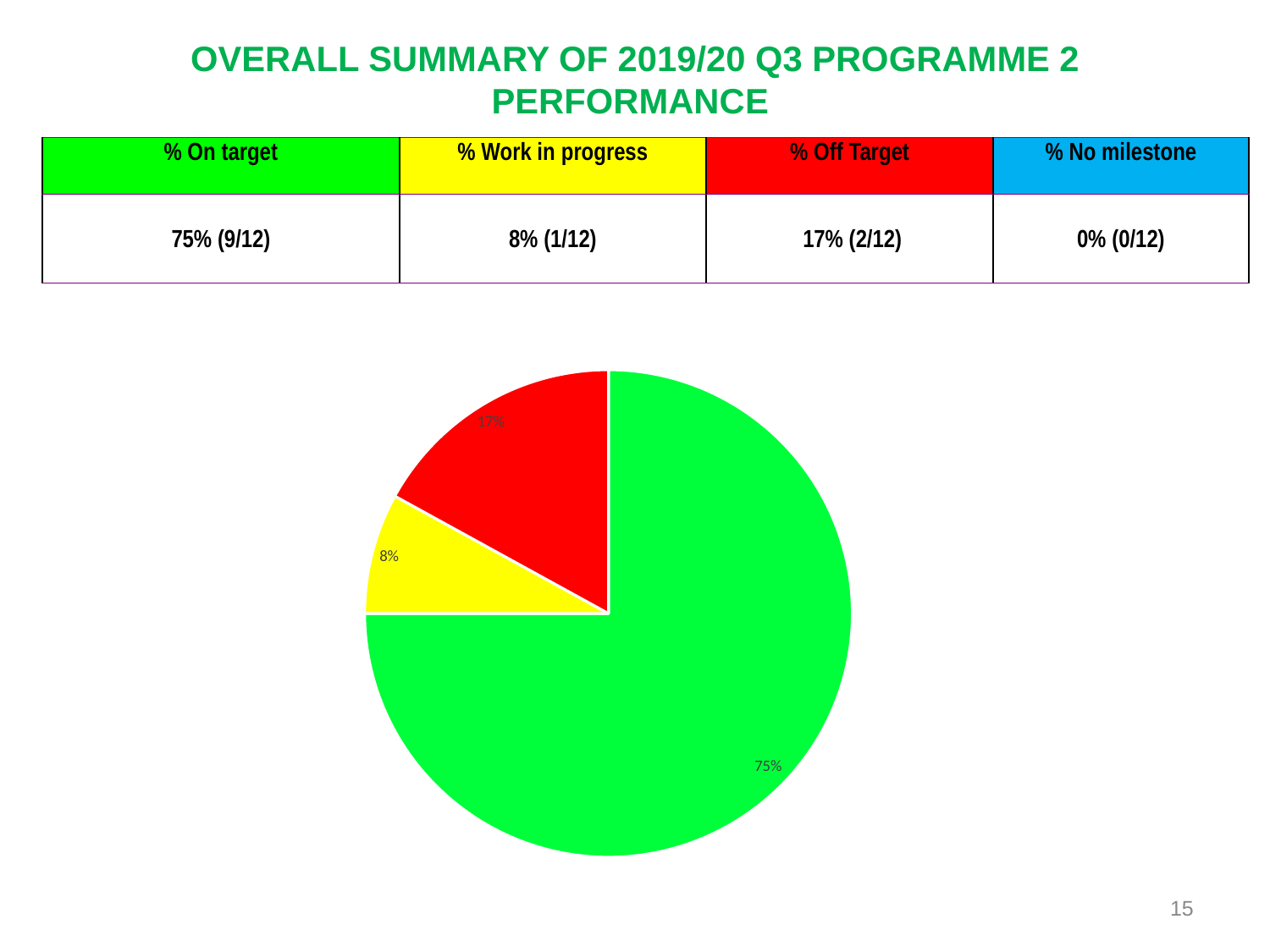
According to the table above the pie chart, which status category does the green slice represent? % On target What percentage is shown on the red slice of the pie chart? 17% What percentage is shown on the green slice of the pie chart? 75% Which status category from the table does not appear as a slice in the pie chart? % No milestone What is the difference in percentage points between the red slice and the yellow slice of the pie chart? 9 Which slice of the pie chart is the smallest? the yellow slice (8%) What percentage is shown on the yellow slice of the pie chart? 8% Which slice of the pie chart is the largest? the green slice (75%) What is the difference in percentage points between the green slice and the red slice of the pie chart? 58 Is the red slice or the yellow slice of the pie chart larger? the red slice What kind of chart is shown on the slide? pie chart How many slices does the pie chart have? 3